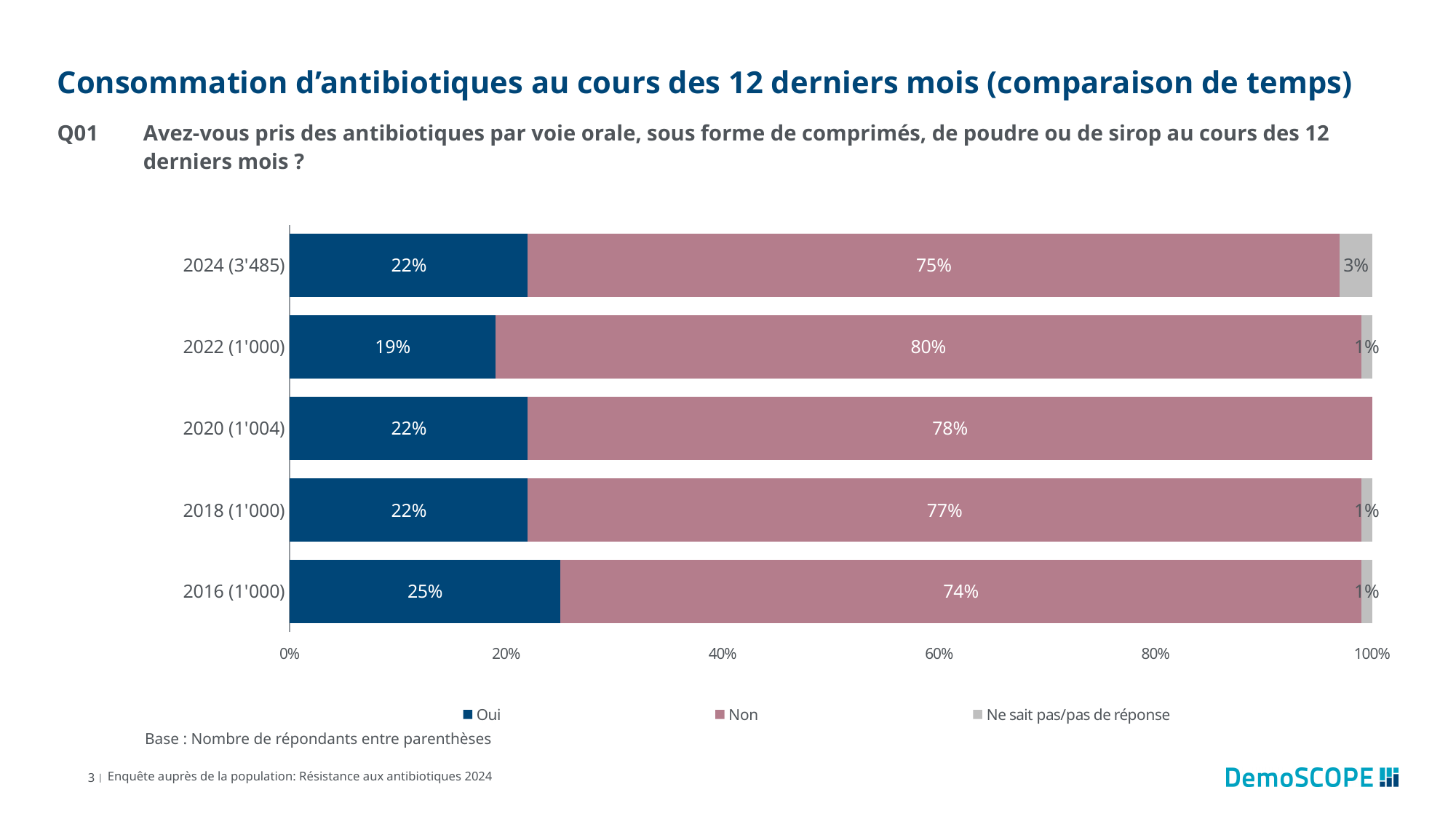
What type of chart is shown on the slide? Stacked bar chart How many series does the legend list? 3 How many years (categories) are shown in the chart? 5 What percentage of respondents answered "Oui" in 2024 (3'485)? 22% Is the "Oui" value larger for 2016 or for 2024? 2016 Which year has the highest "Non" value? 2022 (1'000) What is the "Non" value for 2022 (1'000)? 80% What is the total of the three segments for the 2024 (3'485) bar? 100% What is the "Ne sait pas/pas de réponse" share for 2024 (3'485)? 3% Which year has the lowest "Oui" value? 2022 (1'000) Which year has the highest "Oui" value? 2016 (1'000) What is the difference in percentage points between the "Non" value for 2022 and the "Non" value for 2024? 5